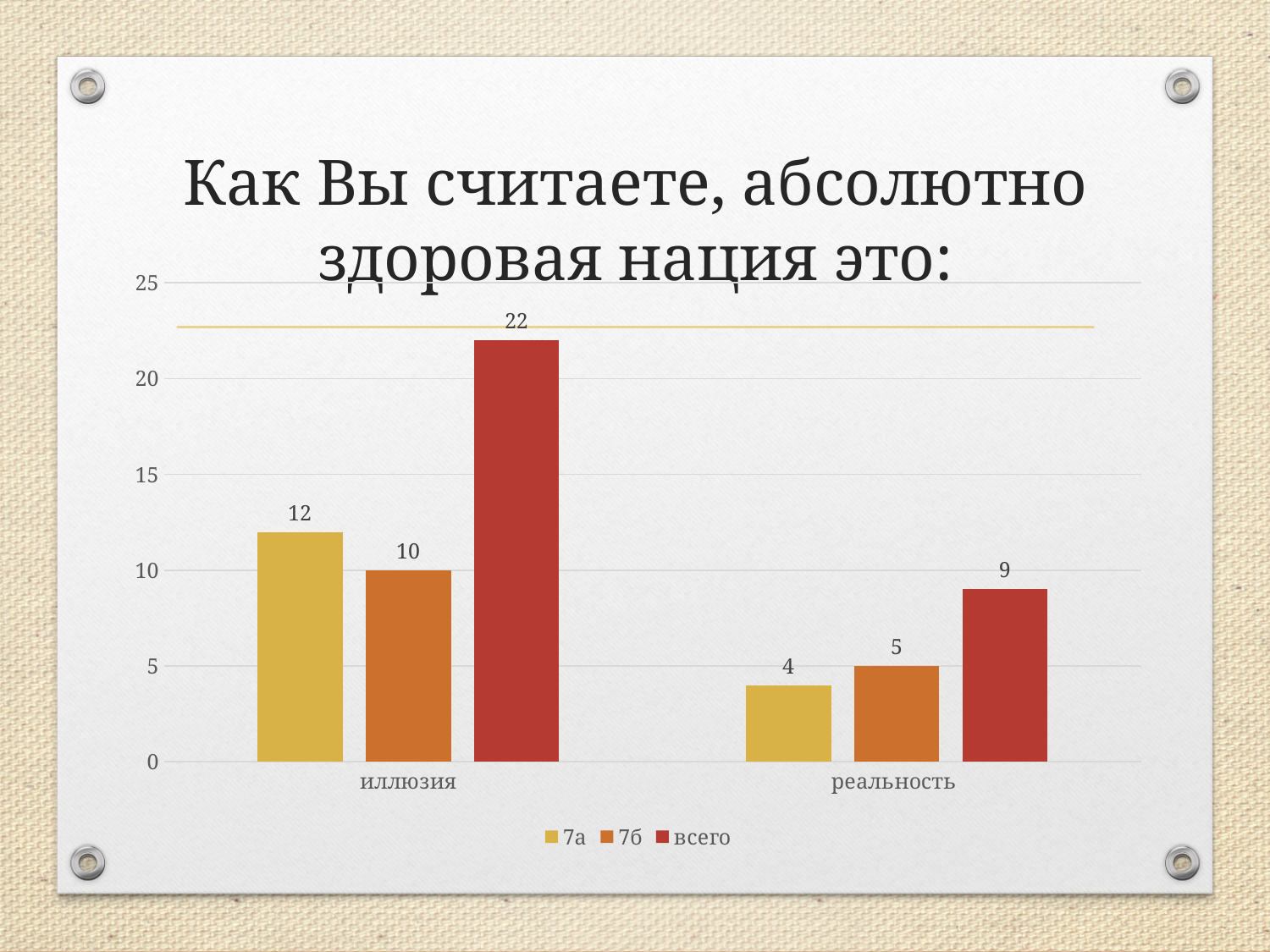
How many series does the legend list? 3 Which category has the highest value for the всего series? иллюзия What kind of chart is shown on the slide? bar chart What is the difference between the всего values for иллюзия and реальность? 13 Which series has the lowest value in the реальность category? 7а What is the value for 7а in the иллюзия category? 12 What is the value for всего in the реальность category? 9 What is the value for всего in the иллюзия category? 22 Is the value for всего in иллюзия greater or less than 20? greater Which is larger: the 7а value for иллюзия or the 7б value for иллюзия? 7а value for иллюзия How many categories are shown on the x axis? 2 What is the value for 7б in the реальность category? 5